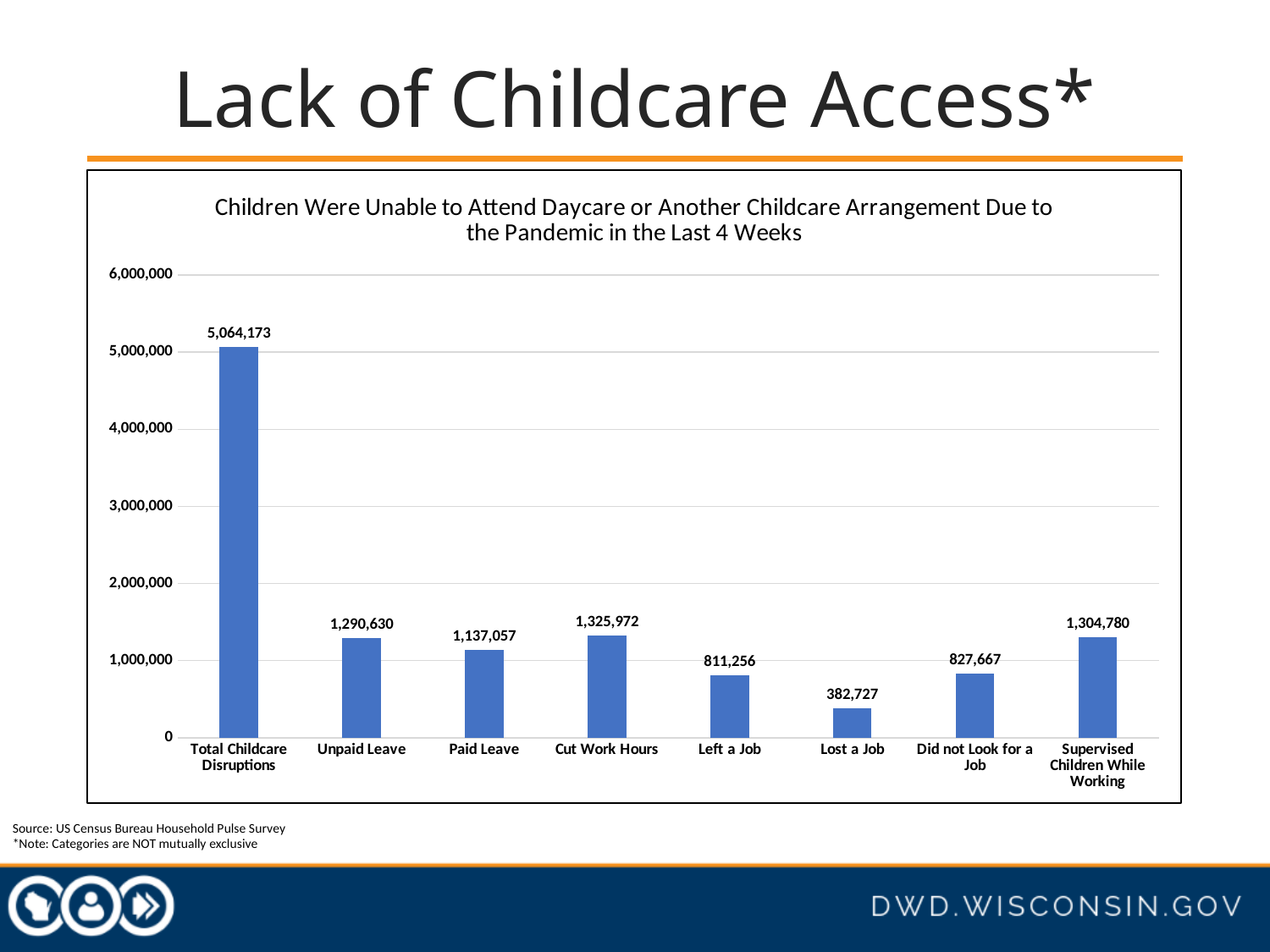
What is the value for Lost a Job? 382,727 What is the value for Did not Look for a Job? 827,667 What is the title of the chart? Children Were Unable to Attend Daycare or Another Childcare Arrangement Due to the Pandemic in the Last 4 Weeks Which category has the highest value? Total Childcare Disruptions Which category has the lowest value? Lost a Job What kind of chart is shown? bar chart Which is larger, Unpaid Leave or Paid Leave? Unpaid Leave What is the value for Supervised Children While Working? 1,304,780 How many categories are shown on the x axis? 8 What is the value for Total Childcare Disruptions? 5,064,173 Is the value for Left a Job greater or less than 1,000,000? less What is the difference between Cut Work Hours and Paid Leave? 188,915